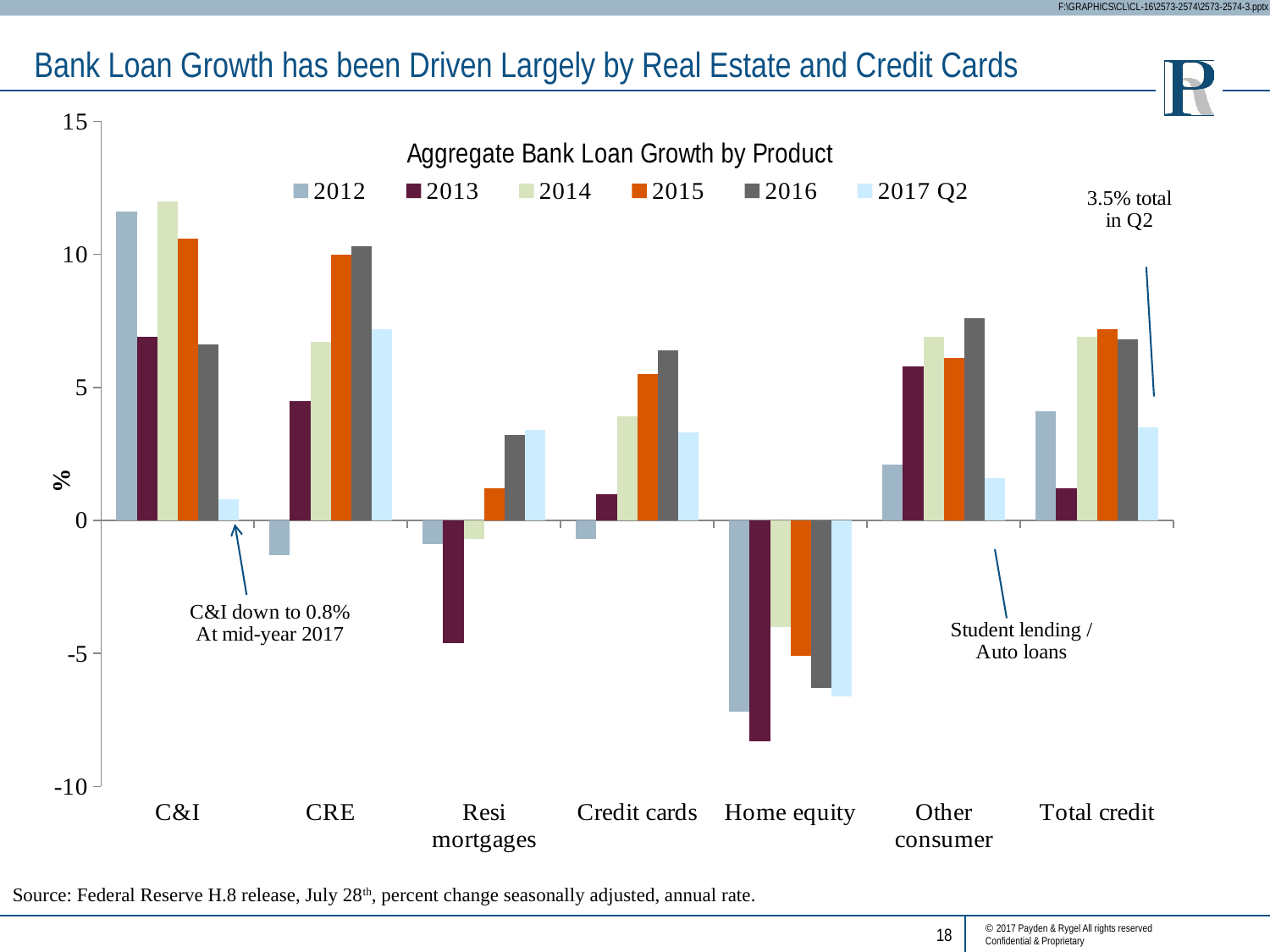
According to the annotation, what is the C&I loan growth value at mid-year 2017? 0.8% Which is larger for 2012: the value for C&I or the value for CRE? C&I What is the title of the chart? Aggregate Bank Loan Growth by Product How many product categories are shown on the x axis? 7 Is the 2013 value for Home equity greater or less than -5? less Which category has the highest value for the 2012 series? C&I How many series does the legend list? 6 What kind of chart is shown on the slide? Bar chart Which category has the lowest value for the 2013 series? Home equity Is the 2012 value for C&I greater or less than 10? greater According to the annotation, what is the total credit growth in Q2 2017? 3.5% Is the 2016 value for Other consumer greater or less than 5? greater